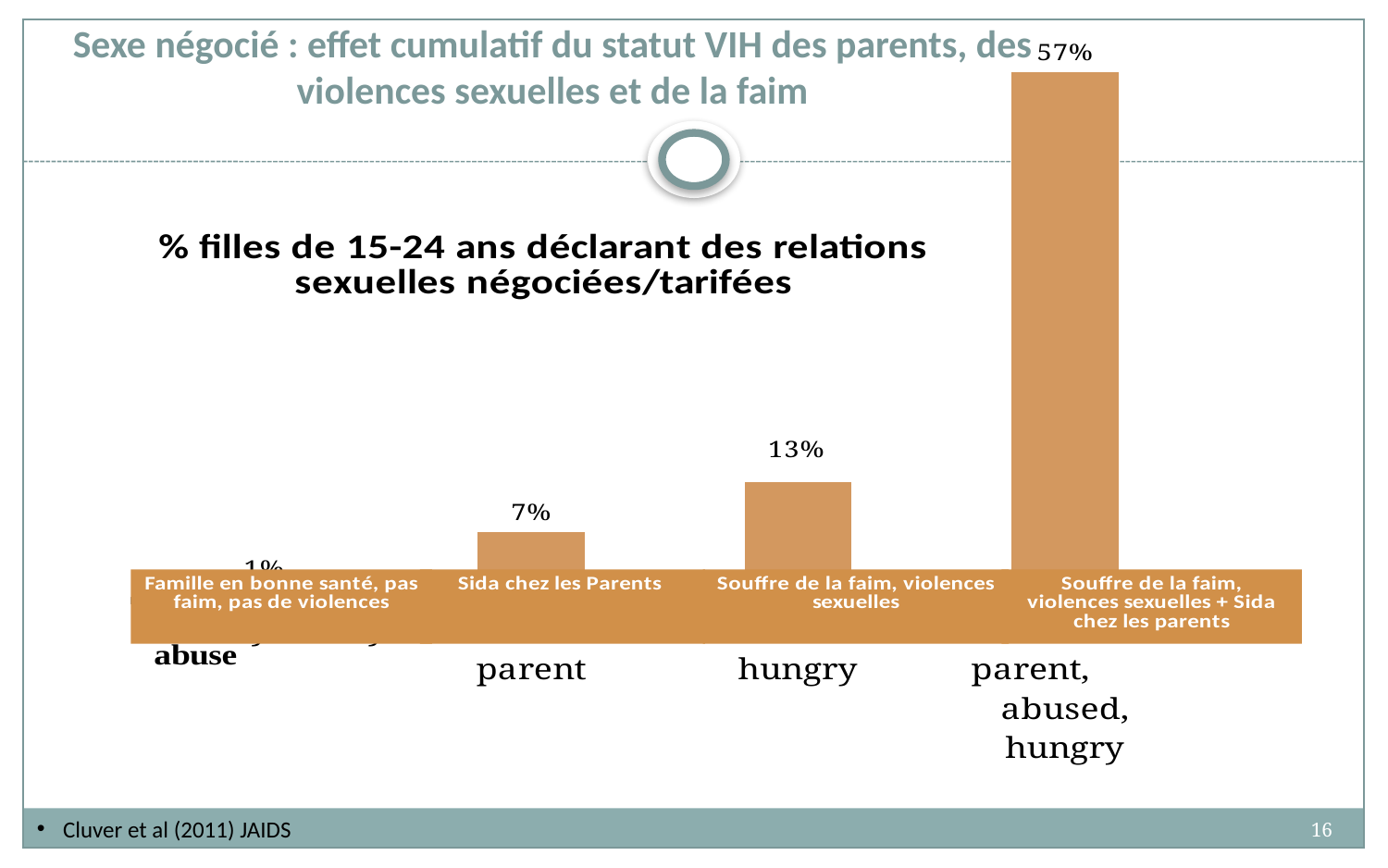
Which category has the lowest value? Famille en bonne santé, pas faim, pas de violences Do the values rise or fall from left to right across the categories? Rise Which category has the highest value? Souffre de la faim, violences sexuelles + Sida chez les parents How many categories are shown in the chart? 4 What kind of chart is shown on the slide? Bar chart What is the value for 'Sida chez les Parents'? 7% What is the difference between the values for 'Souffre de la faim, violences sexuelles' and 'Sida chez les Parents'? 6% Which is larger, the value for 'Sida chez les Parents' or the value for 'Souffre de la faim, violences sexuelles'? Souffre de la faim, violences sexuelles What is the value for 'Souffre de la faim, violences sexuelles'? 13% What is the difference between the values for 'Souffre de la faim, violences sexuelles + Sida chez les parents' and 'Souffre de la faim, violences sexuelles'? 44% What is the value for 'Famille en bonne santé, pas faim, pas de violences'? 1% What is the value for 'Souffre de la faim, violences sexuelles + Sida chez les parents'? 57%